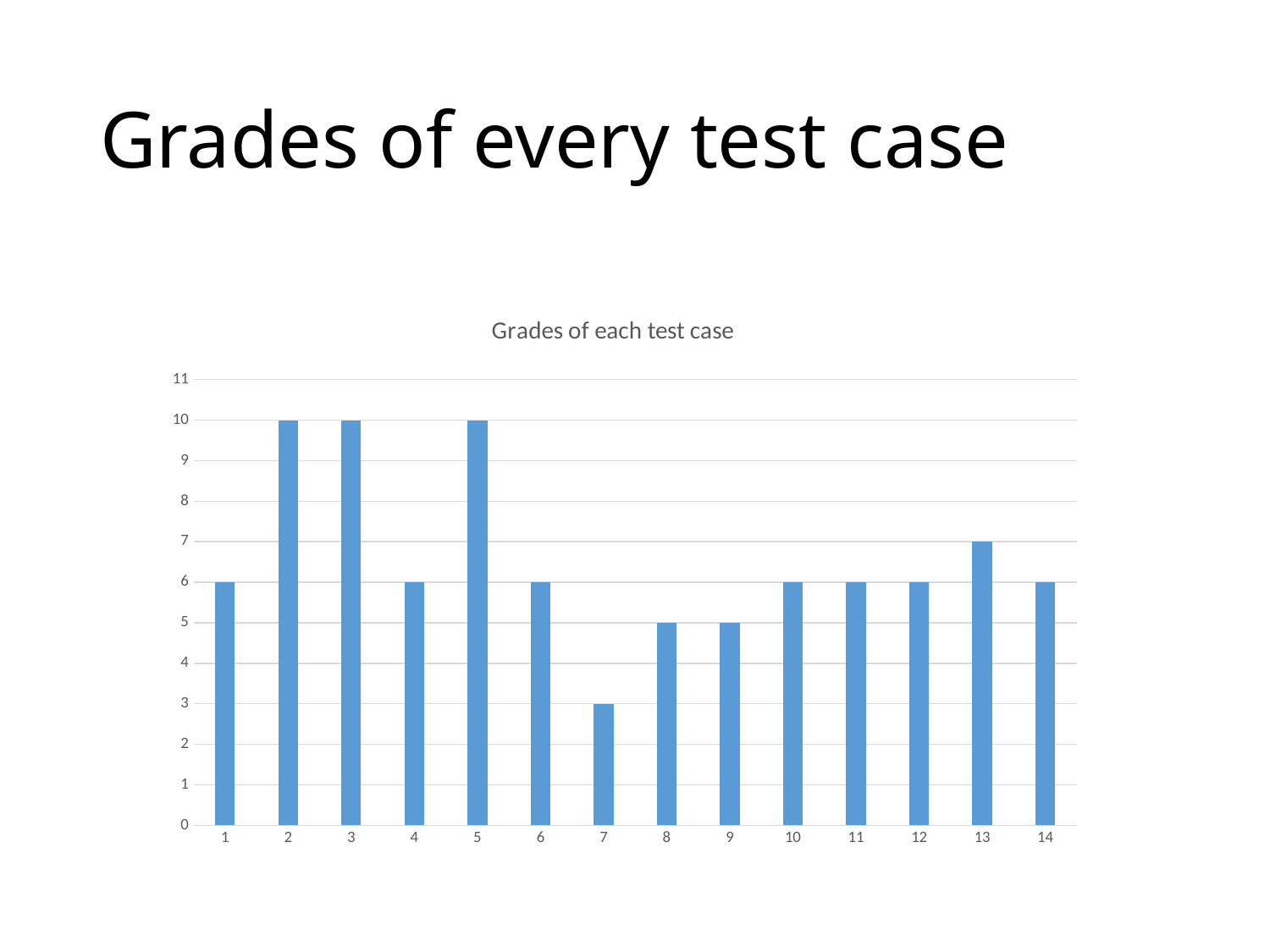
How many test cases are shown on the x axis? 14 What is the difference between the grades of test case 5 and test case 7? 7 What is the difference between the grades of test case 13 and test case 9? 2 Is the grade for test case 13 greater or less than 6? greater What is the highest value shown on the y axis? 11 What is the grade for test case 13? 7 Which has a higher grade, test case 3 or test case 8? Test case 3 What is the title of the chart? Grades of each test case What kind of chart is shown on the slide? Bar chart What is the grade for test case 2? 10 Which test case has the lowest grade? 7 What is the grade for test case 7? 3